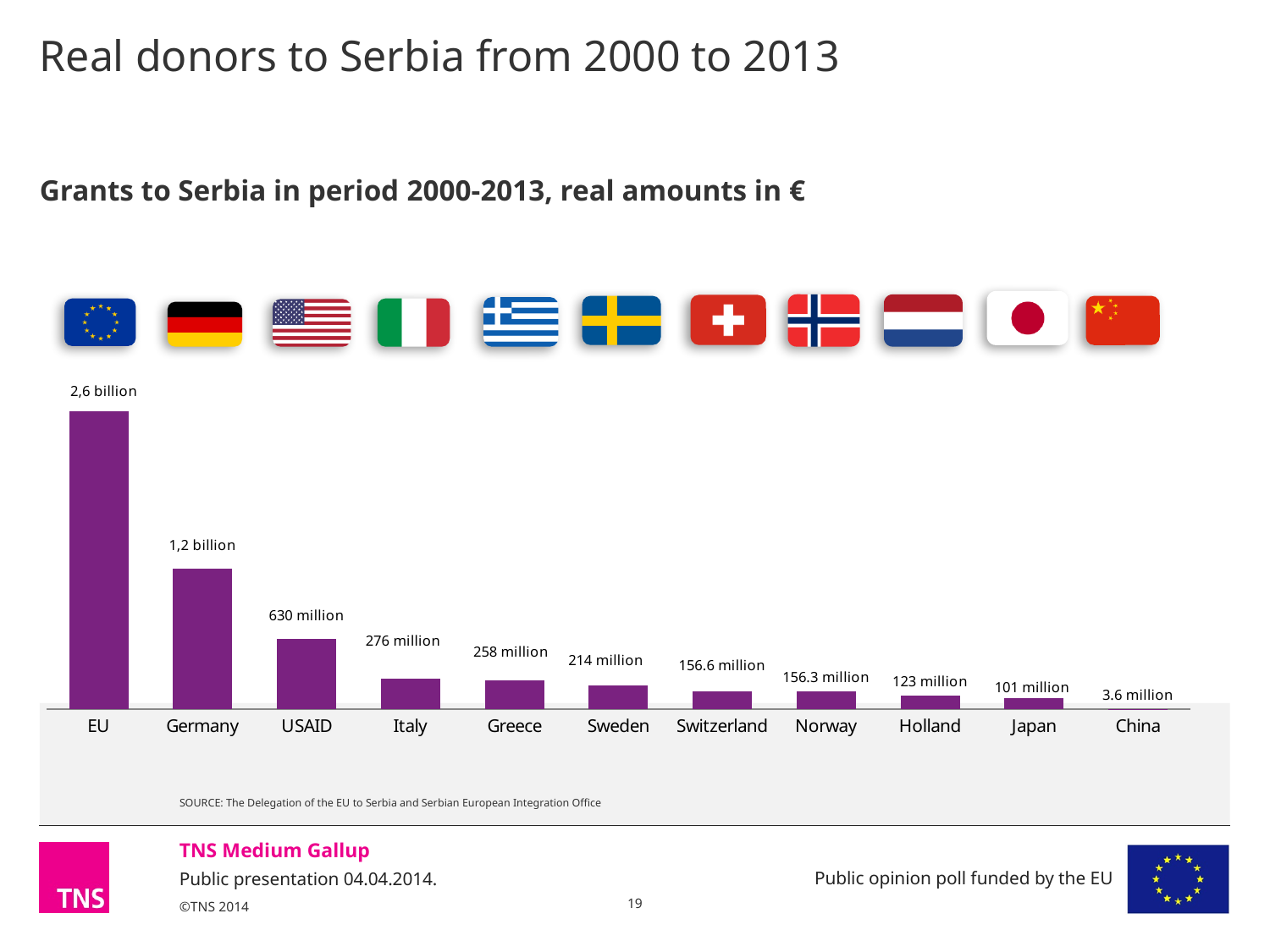
What is the value for USAID? 630 million Which donor has the lowest value? China What is the value for Germany? 1,2 billion What is the difference between the values for Holland and Japan? 22 million Which is larger, the value for Sweden or the value for Greece? Greece What is the difference between the values for Italy and Greece? 18 million Which donor has the highest value? EU What is the value for Switzerland? 156.6 million Do the values rise or fall from left to right along the x axis? Fall What kind of chart is shown on the slide? Bar chart What is the value for China? 3.6 million How many donors are shown in the chart? 11